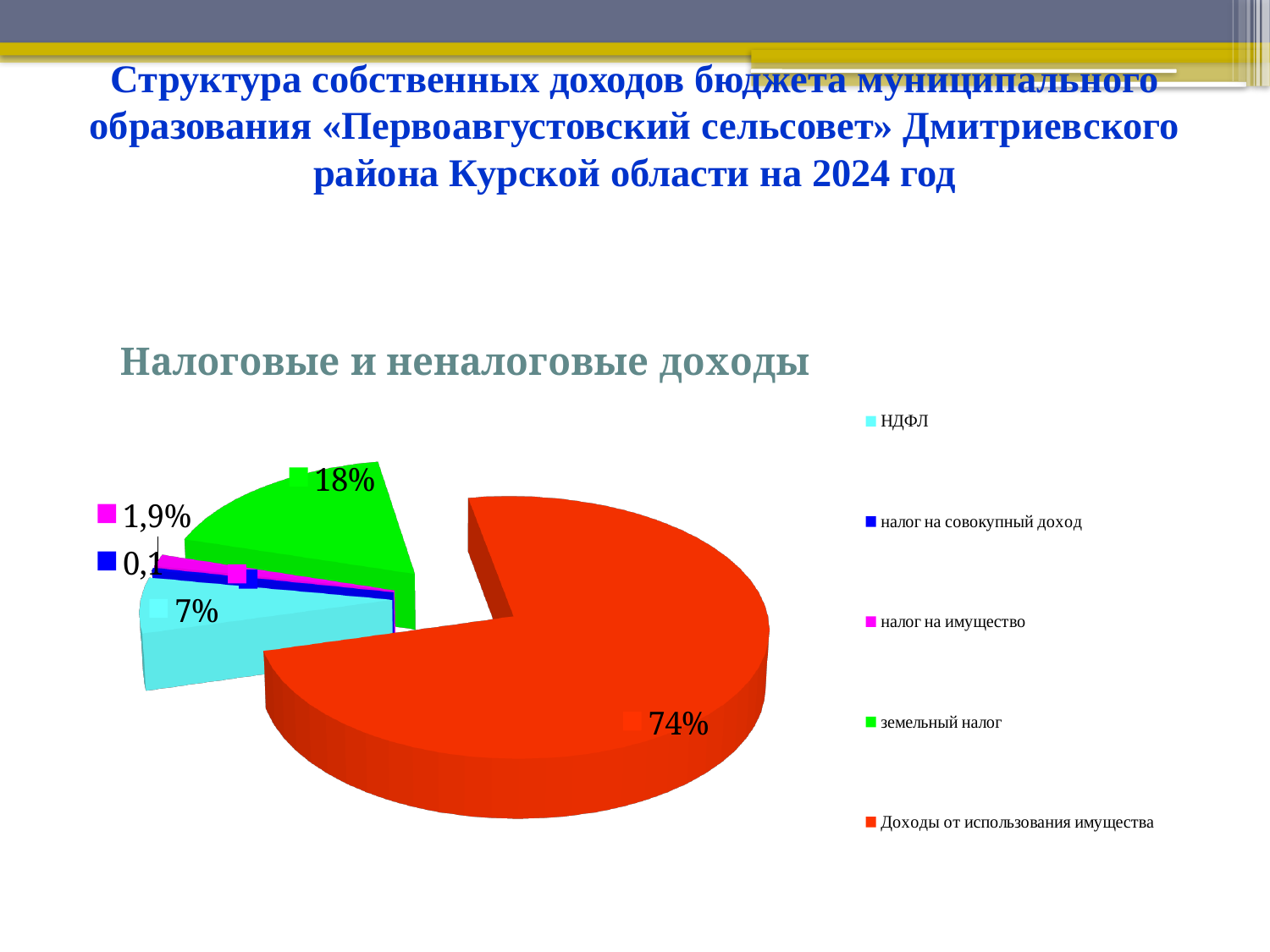
What share of the pie does земельный налог have? 18% What is the title of the chart? Налоговые и неналоговые доходы What is the difference between the share for Доходы от использования имущества and the share for земельный налог? 56% What value is shown for налог на имущество? 1,9% How many categories does the legend of the pie chart list? 5 Which category has the smallest share of the pie? налог на совокупный доход Which category has the largest share of the pie? Доходы от использования имущества What share of the pie does Доходы от использования имущества have? 74% Which is larger, the share for земельный налог or the share for НДФЛ? земельный налог What kind of chart is shown on the slide? pie chart What value is shown for налог на совокупный доход? 0,1 What share of the pie does НДФЛ have? 7%